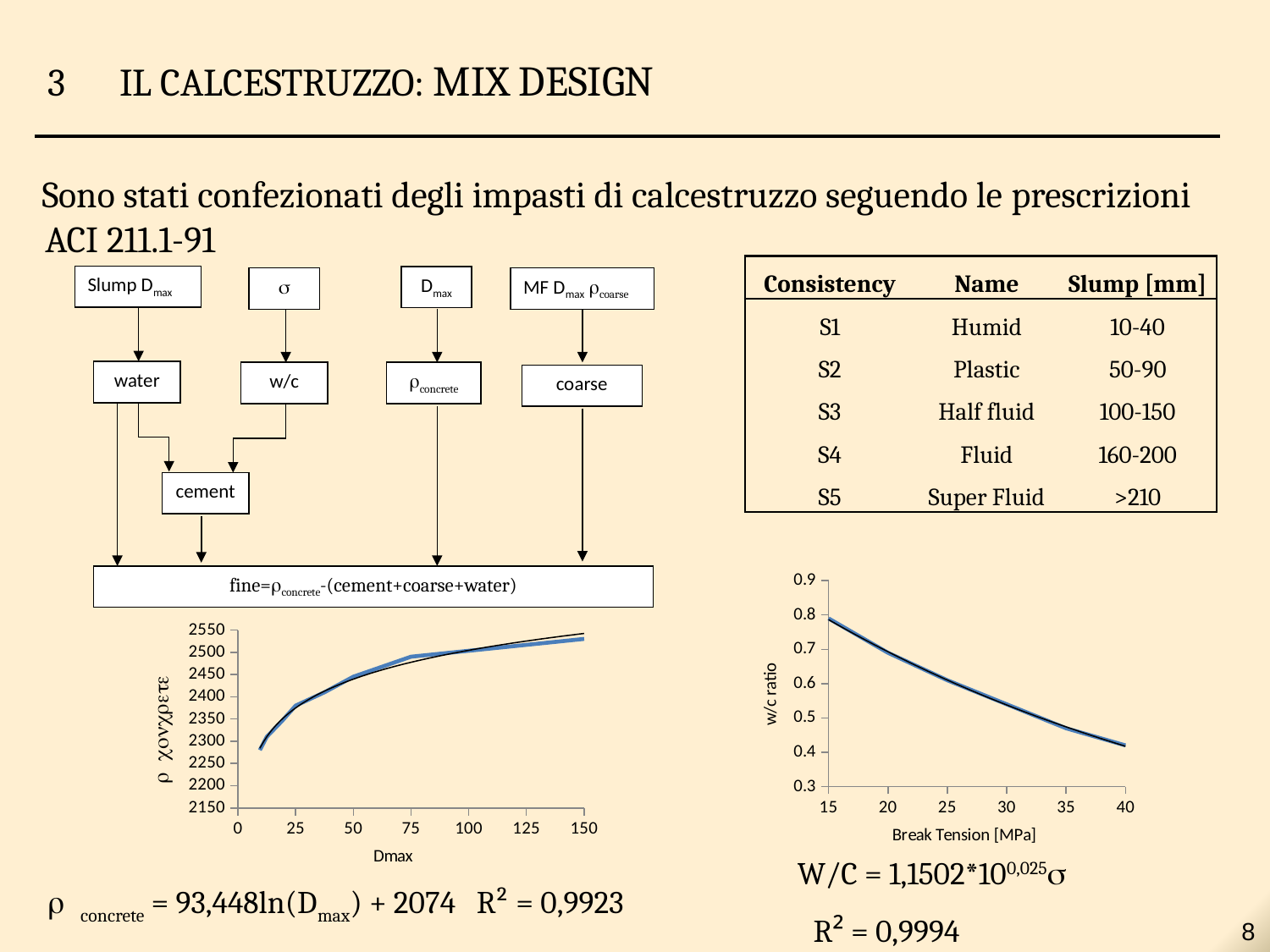
In the bottom-left chart, is the ρ concrete value at Dmax = 150 greater or less than 2500? greater In the bottom-right chart, do the w/c ratio values rise or fall as Break Tension increases? fall In the bottom-right chart, which is larger: the w/c ratio at 15 MPa or at 40 MPa? 15 MPa In the bottom-right chart, is the w/c ratio at a Break Tension of 15 MPa greater or less than 0.7? greater In the bottom-left chart, which is larger: the ρ concrete value at Dmax = 150 or at Dmax = 25? Dmax = 150 What kind of chart is the bottom-right chart with Break Tension [MPa] on the x axis? line chart What kind of chart is the bottom-left chart with Dmax on the x axis? line chart In the bottom-right chart, is the w/c ratio at a Break Tension of 35 MPa greater or less than 0.5? less What is the x-axis label of the bottom-right chart? Break Tension [MPa] In the bottom-left chart, do the ρ concrete values rise or fall as Dmax increases? rise